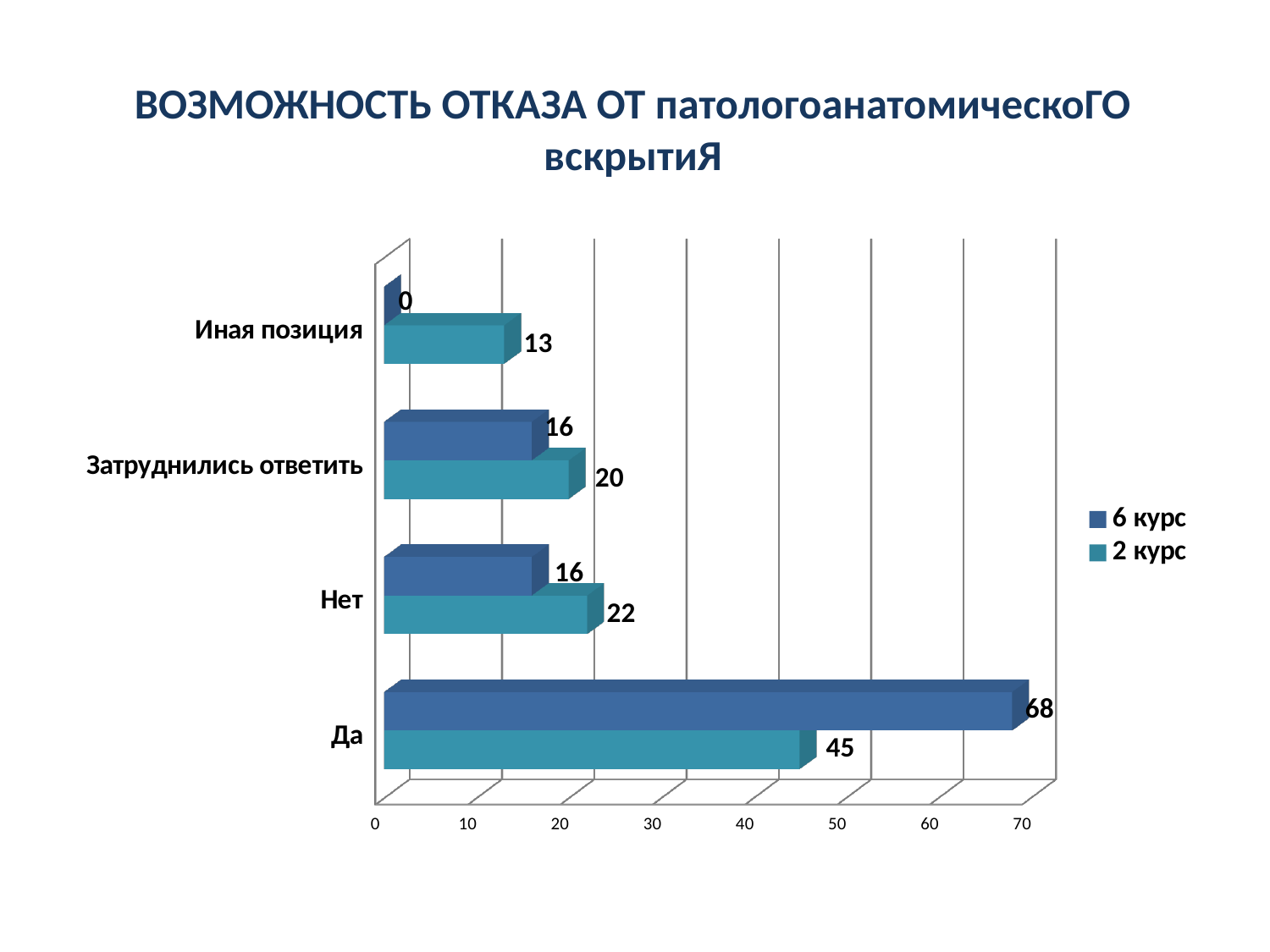
Which category has the highest value in the "6 курс" series? Да What are the two series named in the legend? 6 курс and 2 курс Which is larger for "Нет": the "6 курс" value or the "2 курс" value? 2 курс What is the value for "Иная позиция" in the "6 курс" series? 0 What is the value for "Да" in the "2 курс" series? 45 How many categories are shown on the chart? 4 What is the value for "Нет" in the "2 курс" series? 22 What is the value for "Да" in the "6 курс" series? 68 Which category has the lowest value in the "2 курс" series? Иная позиция What kind of chart is shown on the slide? Bar chart How many series does the legend list? 2 What is the difference between the "6 курс" and "2 курс" values for "Да"? 23